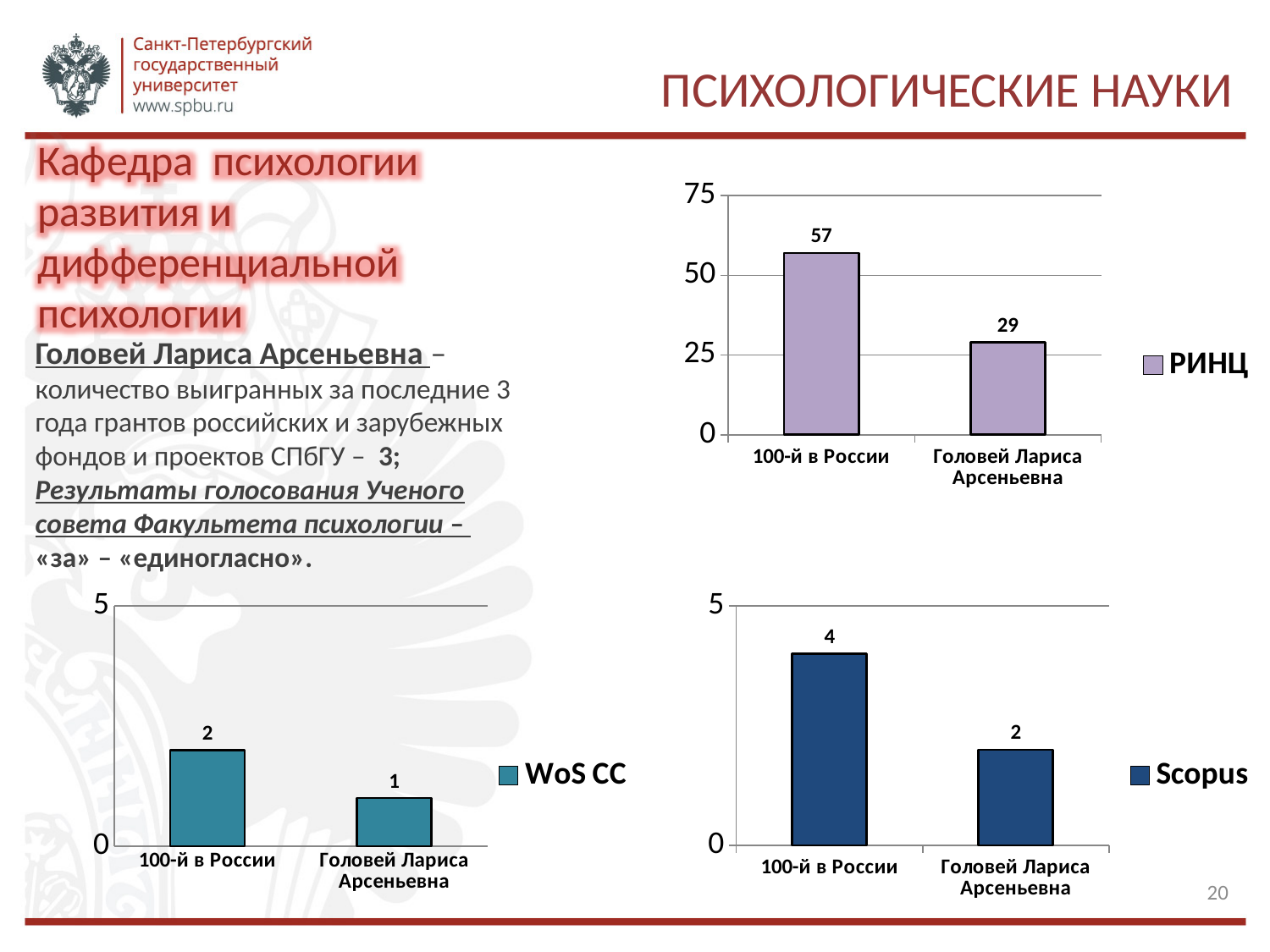
In the РИНЦ chart (top right), what is the difference between the values for 100-й в России and Головей Лариса Арсеньевна? 28 What kind of chart is the Scopus chart (bottom right)? Bar chart In the WoS CC chart (bottom left), which category has the lowest value? Головей Лариса Арсеньевна How many categories are shown in the РИНЦ chart (top right)? 2 In the Scopus chart (bottom right), what is the value for 100-й в России? 4 In the WoS CC chart (bottom left), what is the value for Головей Лариса Арсеньевна? 1 In the РИНЦ chart (top right), what is the value for Головей Лариса Арсеньевна? 29 In the Scopus chart (bottom right), what is the difference between the values for 100-й в России and Головей Лариса Арсеньевна? 2 In the Scopus chart (bottom right), what is the value for Головей Лариса Арсеньевна? 2 In the WoS CC chart (bottom left), what is the value for 100-й в России? 2 In the РИНЦ chart (top right), which category has the highest value? 100-й в России In the РИНЦ chart (top right), what is the value for 100-й в России? 57